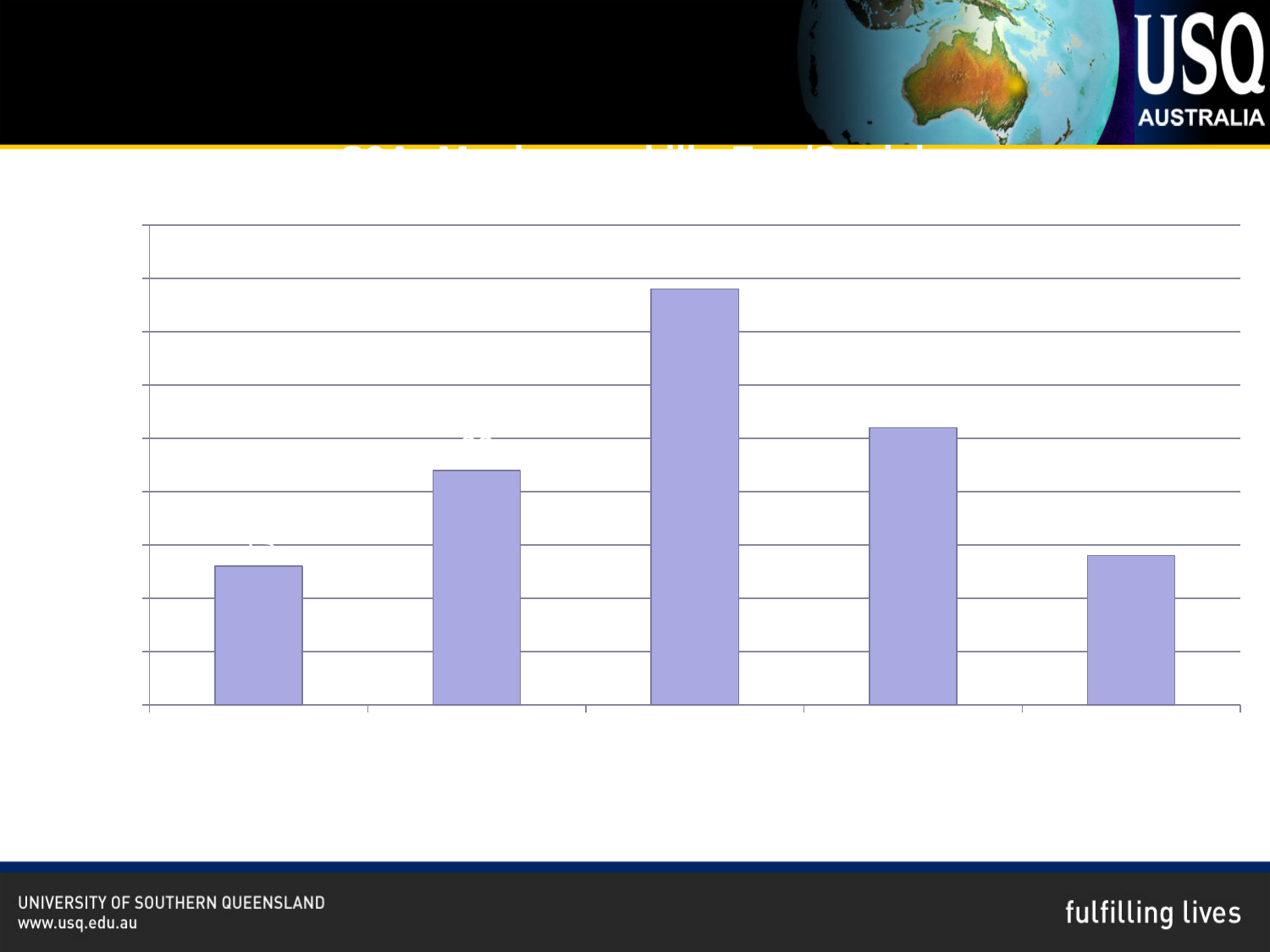
Is the third bar from the left taller or shorter than the fourth bar from the left? taller Is the fourth bar from the left taller or shorter than the second bar from the left? taller Are the bars in the chart vertical or horizontal? vertical What colour are the bars in the chart? light purple (lavender) Which bar in the chart is the tallest, counting from the left? the third (middle) bar Do the bar heights rise steadily, fall steadily, or rise and then fall from left to right? rise and then fall Is the second bar from the left taller or shorter than the first bar from the left? taller How many bars are plotted in the chart? 5 What kind of chart is shown on the slide? bar chart